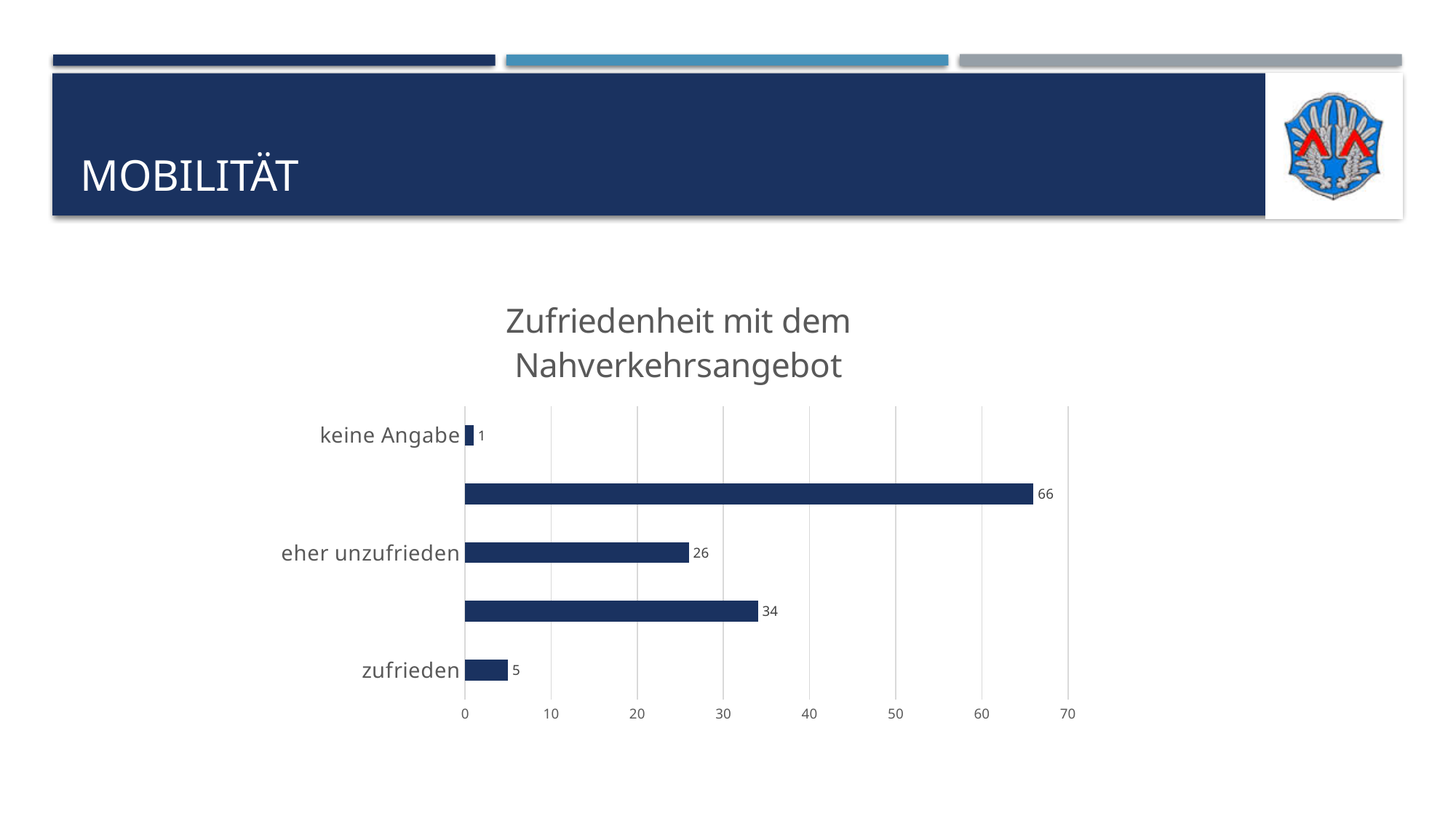
What is the value for "keine Angabe" in the chart? 1 What is the value for "eher unzufrieden" in the chart "Zufriedenheit mit dem Nahverkehrsangebot"? 26 What is the difference between the values for "eher unzufrieden" and "zufrieden"? 21 What is the value for "zufrieden" in the chart? 5 What is the highest tick value shown on the horizontal axis of the chart? 70 Is the value for "eher unzufrieden" greater or less than 30? less What kind of chart is shown on the slide? bar chart What is the title of the chart on the slide? Zufriedenheit mit dem Nahverkehrsangebot Which labelled category has the lowest value in the chart? keine Angabe How many bars are plotted in the chart? 5 What is the largest value shown by any bar in the chart? 66 Which is larger, the value for "eher unzufrieden" or the value for "zufrieden"? eher unzufrieden